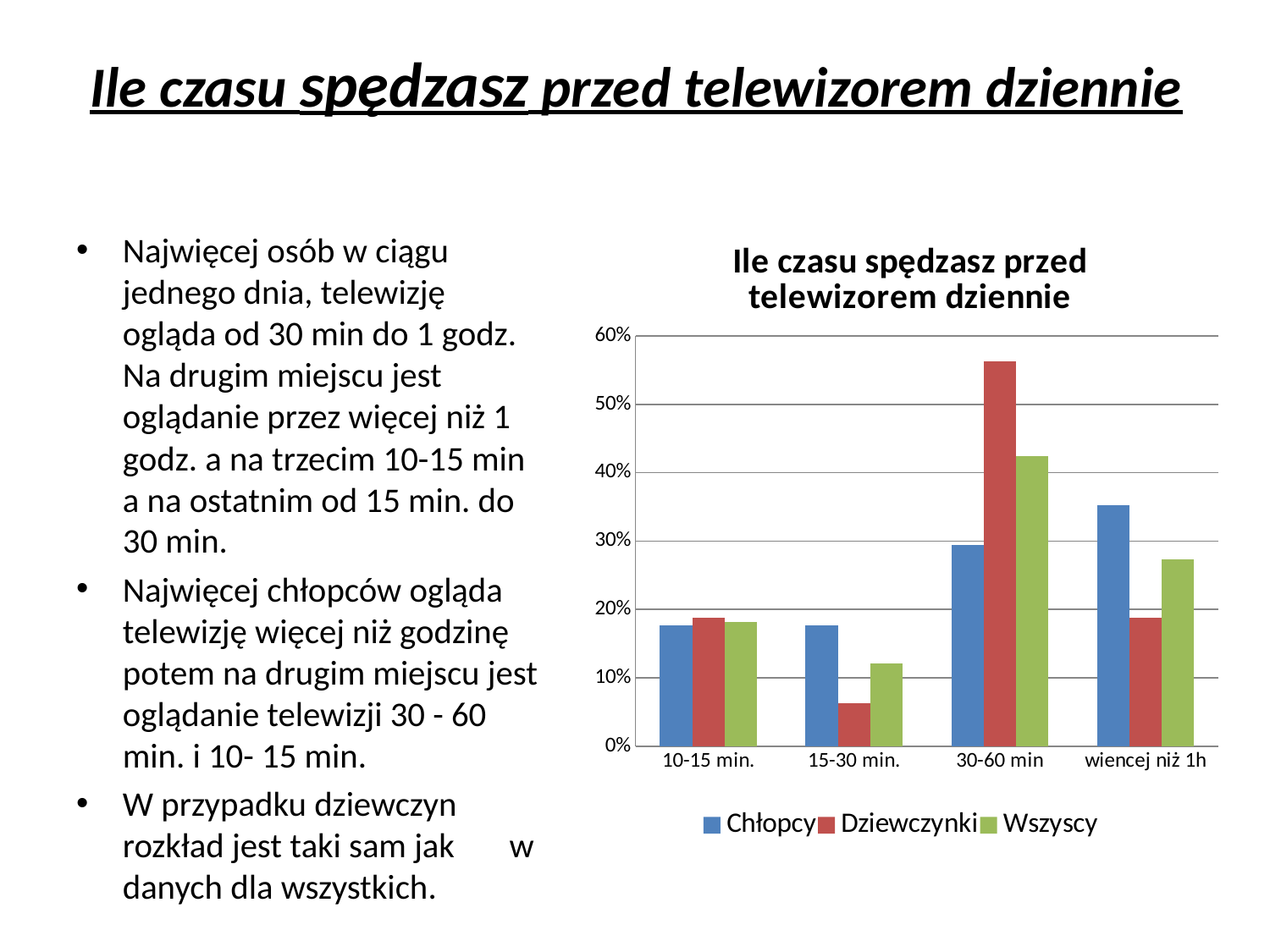
For the Dziewczynki series, which category has the highest value? 30-60 min For the Chłopcy series, which category has the highest value? wiencej niż 1h Is the value for Dziewczynki in the 30-60 min category greater or less than 50%? greater Is the value for Wszyscy in the 30-60 min category greater or less than 30%? greater How many categories are shown on the x axis of the chart? 4 How many series does the chart legend list? 3 Is the value for Dziewczynki in the 15-30 min. category greater or less than 10%? less For the Wszyscy series, which category has the lowest value? 15-30 min. For the Dziewczynki series, which category has the lowest value? 15-30 min. What is the title of the chart? Ile czasu spędzasz przed telewizorem dziennie In the 15-30 min. category, which is larger: Chłopcy or Dziewczynki? Chłopcy What kind of chart is shown on the slide? bar chart